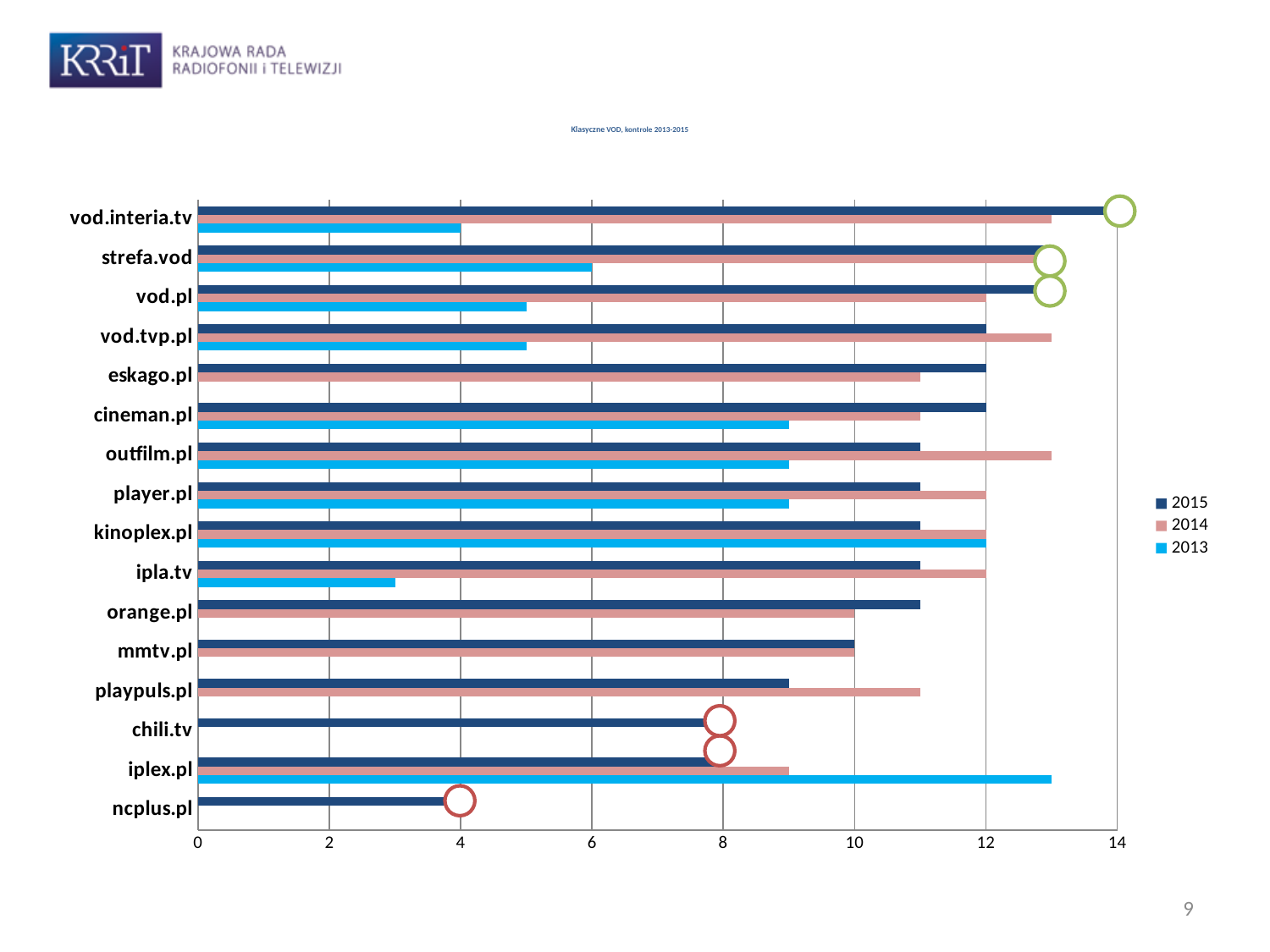
Which service has the highest 2015 value? vod.interia.tv What is the difference between the 2015 value and the 2013 value for vod.interia.tv? 10 What kind of chart is shown on the slide? bar chart How many categories (services) are shown on the vertical axis? 16 Is the 2015 value for chili.tv greater or less than 10? less Which service has the lowest 2015 value? ncplus.pl Which is larger for outfilm.pl: the 2014 value or the 2015 value? 2014 What is the title of the chart? Klasyczne VOD, kontrole 2013-2015 What is the 2015 value for vod.interia.tv? 14 How many series does the legend list? 3